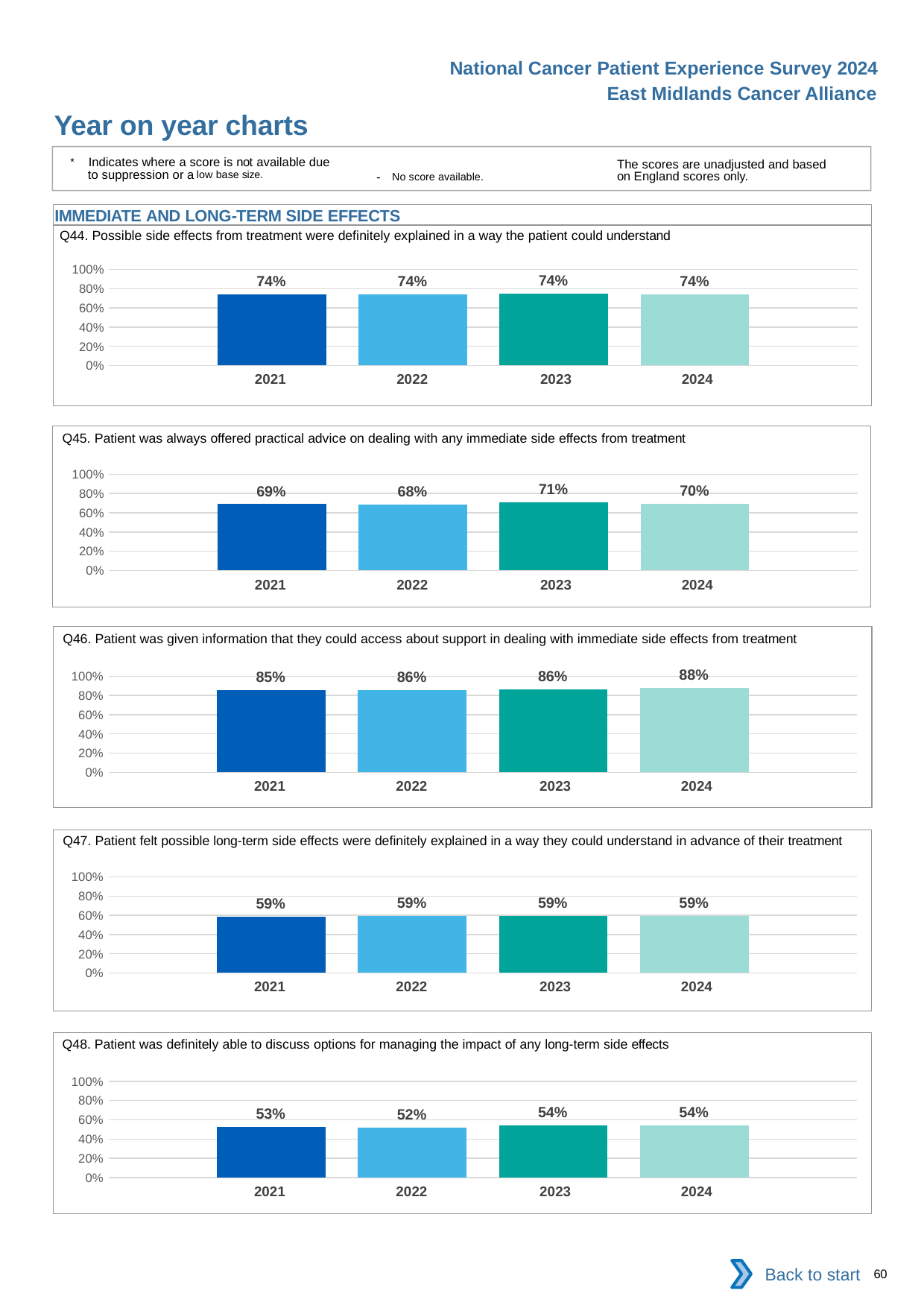
How many years are shown on the x axis of the Q45 chart? 4 In the Q46 chart, what is the difference between the 2024 value and the 2021 value? 3% In the Q45 chart, what is the difference between the 2023 value and the 2022 value? 3% In the Q46 chart, which year has the highest value? 2024 In the Q48 chart, what is the value for 2023? 54% In the Q45 chart, which year has the highest value? 2023 In the Q47 chart, what is the value for 2022? 59% In the Q48 chart, is the value for 2024 greater or less than 60%? less In the Q45 chart, which year has the lowest value? 2022 What kind of chart is the Q44 chart? bar chart In the Q48 chart, which is larger, the value for 2021 or the value for 2022? 2021 In the Q44 chart, what is the value for 2024? 74%